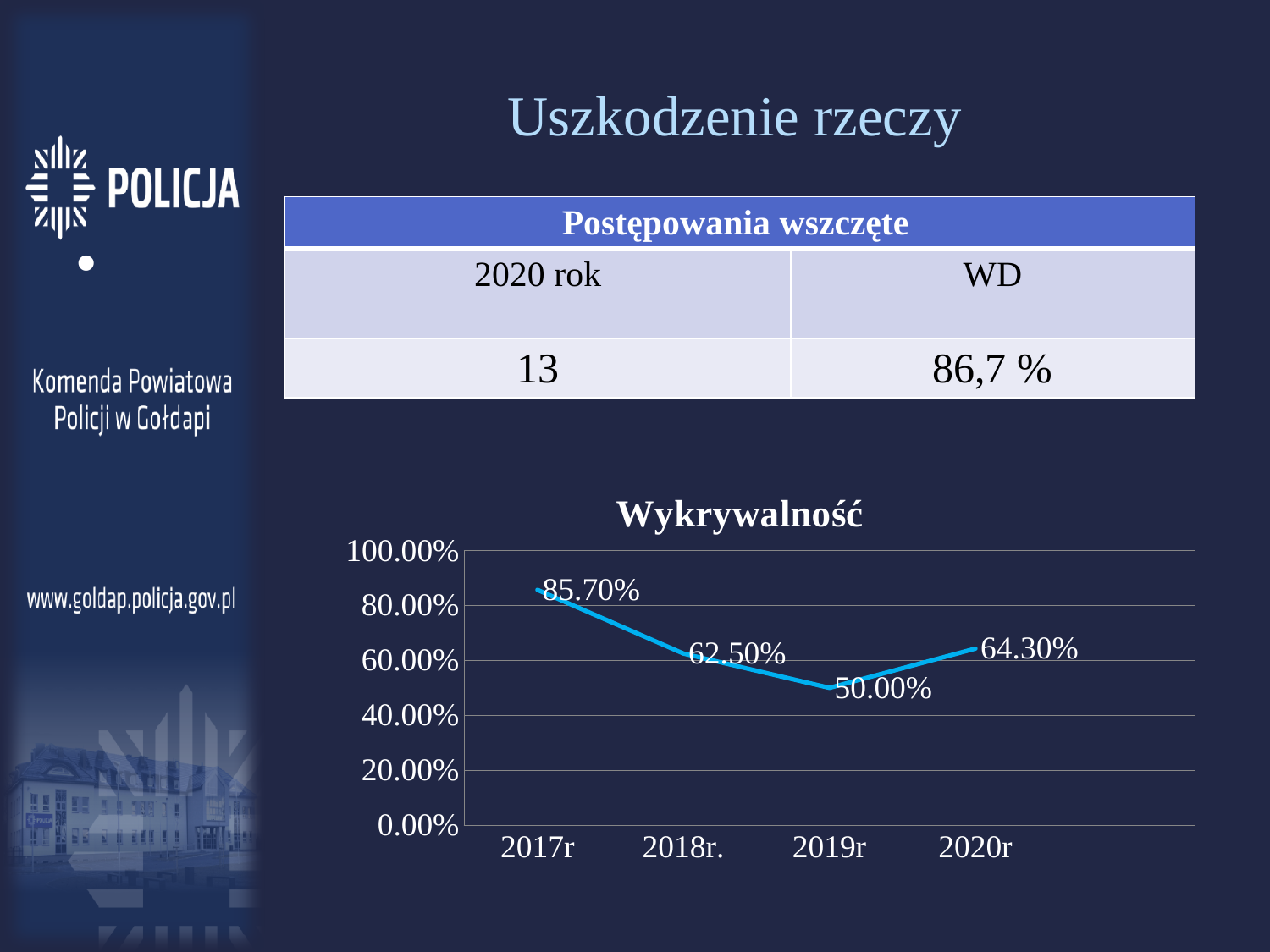
Which is larger in the 'Wykrywalność' chart: the value for 2018r. or the value for 2020r? 2020r What is the value for 2017r in the 'Wykrywalność' chart? 85.70% What is the value for 2020r in the 'Wykrywalność' chart? 64.30% What is the value for 2018r. in the 'Wykrywalność' chart? 62.50% How many data points are plotted in the 'Wykrywalność' chart? 4 What is the difference between the 2017r and 2019r values in the 'Wykrywalność' chart? 35.70% Does the value in the 'Wykrywalność' chart rise or fall from 2017r to 2019r? fall Which year has the lowest value in the 'Wykrywalność' chart? 2019r What is the title of the chart on the slide? Wykrywalność What is the value for 2019r in the 'Wykrywalność' chart? 50.00% What type of chart is shown under the title 'Wykrywalność'? line chart Which year has the highest value in the 'Wykrywalność' chart? 2017r